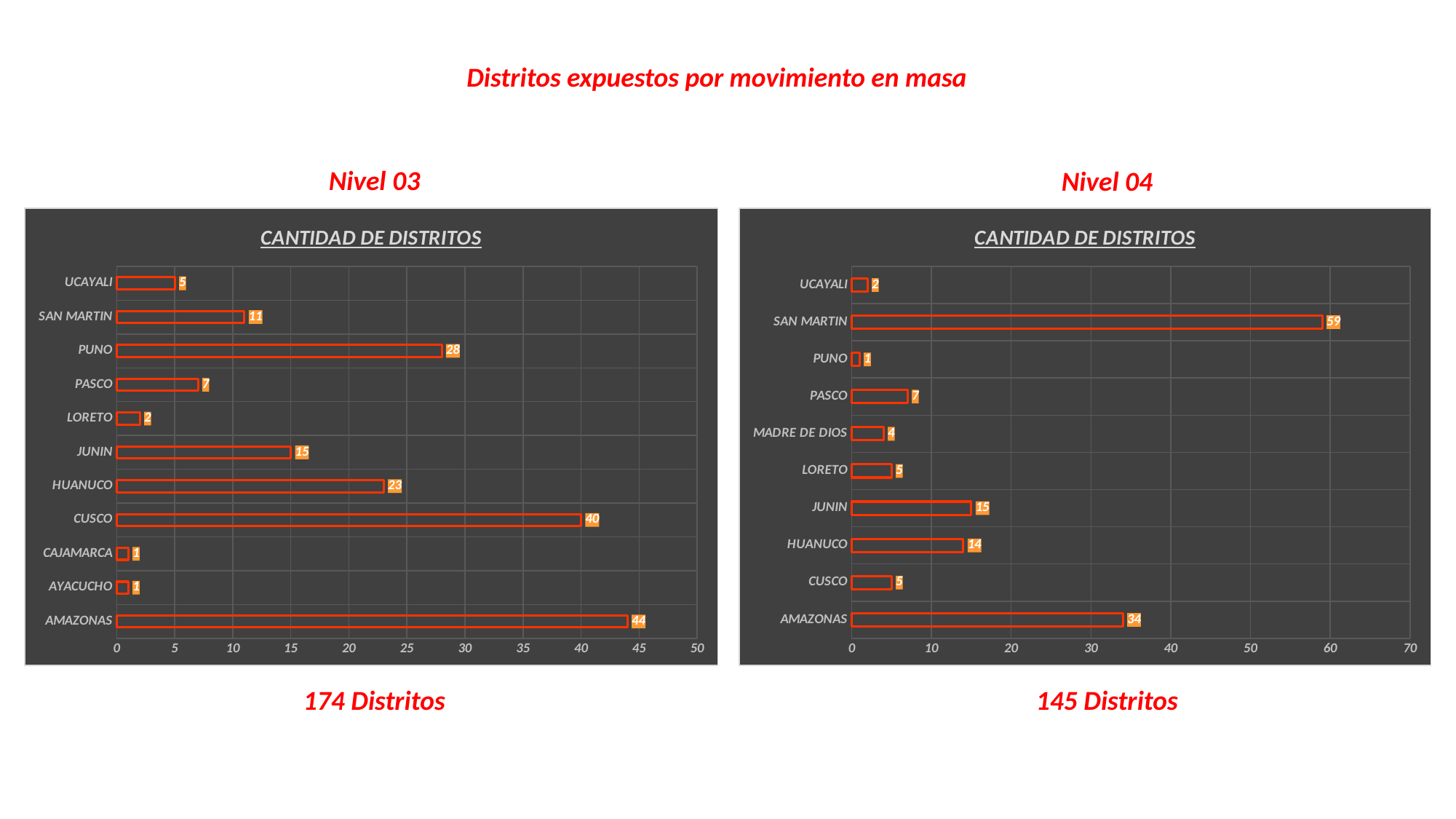
In the Nivel 04 chart (right), is the value for AMAZONAS greater or less than 30? greater How many regions are listed in the Nivel 04 chart (right)? 10 In the Nivel 03 chart (left), which is larger, the value for PUNO or the value for HUANUCO? PUNO In the Nivel 04 chart (right), which region has the lowest number of districts? PUNO What type of chart is the Nivel 04 chart (right)? Bar chart In the Nivel 03 chart (left), which region has the highest number of districts? AMAZONAS In the Nivel 04 chart (right), what is the difference between the values for SAN MARTIN and AMAZONAS? 25 What is the title shown inside the Nivel 03 chart (left)? CANTIDAD DE DISTRITOS In the Nivel 03 chart (left), what is the difference between the values for AMAZONAS and CUSCO? 4 In the Nivel 04 chart (right), how many districts are shown for SAN MARTIN? 59 In the Nivel 03 chart (left), how many districts are shown for CUSCO? 40 How many regions are listed in the Nivel 03 chart (left)? 11